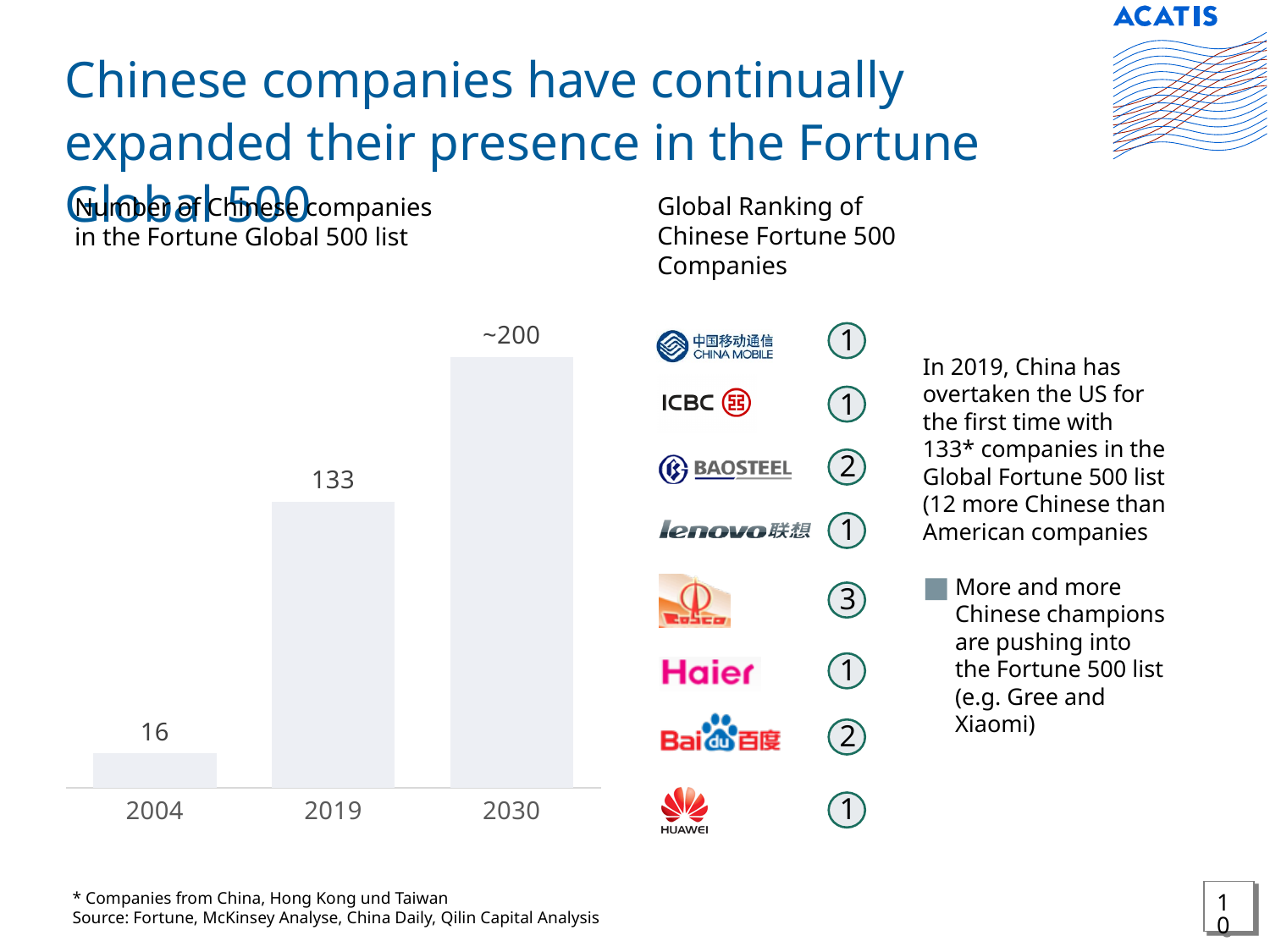
Which is larger, the value for 2019 or the value for 2004? 2019 How many years are shown on the x axis of the chart? 3 What type of chart is shown on the slide? bar chart Do the values rise or fall from 2004 to 2030? rise What is the number of Chinese companies in the Fortune Global 500 list for 2004? 16 What value is labelled on the bar for 2030? ~200 What is the number of Chinese companies in the Fortune Global 500 list for 2019? 133 What is the difference between the values for 2019 and 2004? 117 What is the title of the bar chart? Number of Chinese companies in the Fortune Global 500 list Which year has the lowest bar in the chart? 2004 Which year has the highest bar in the chart? 2030